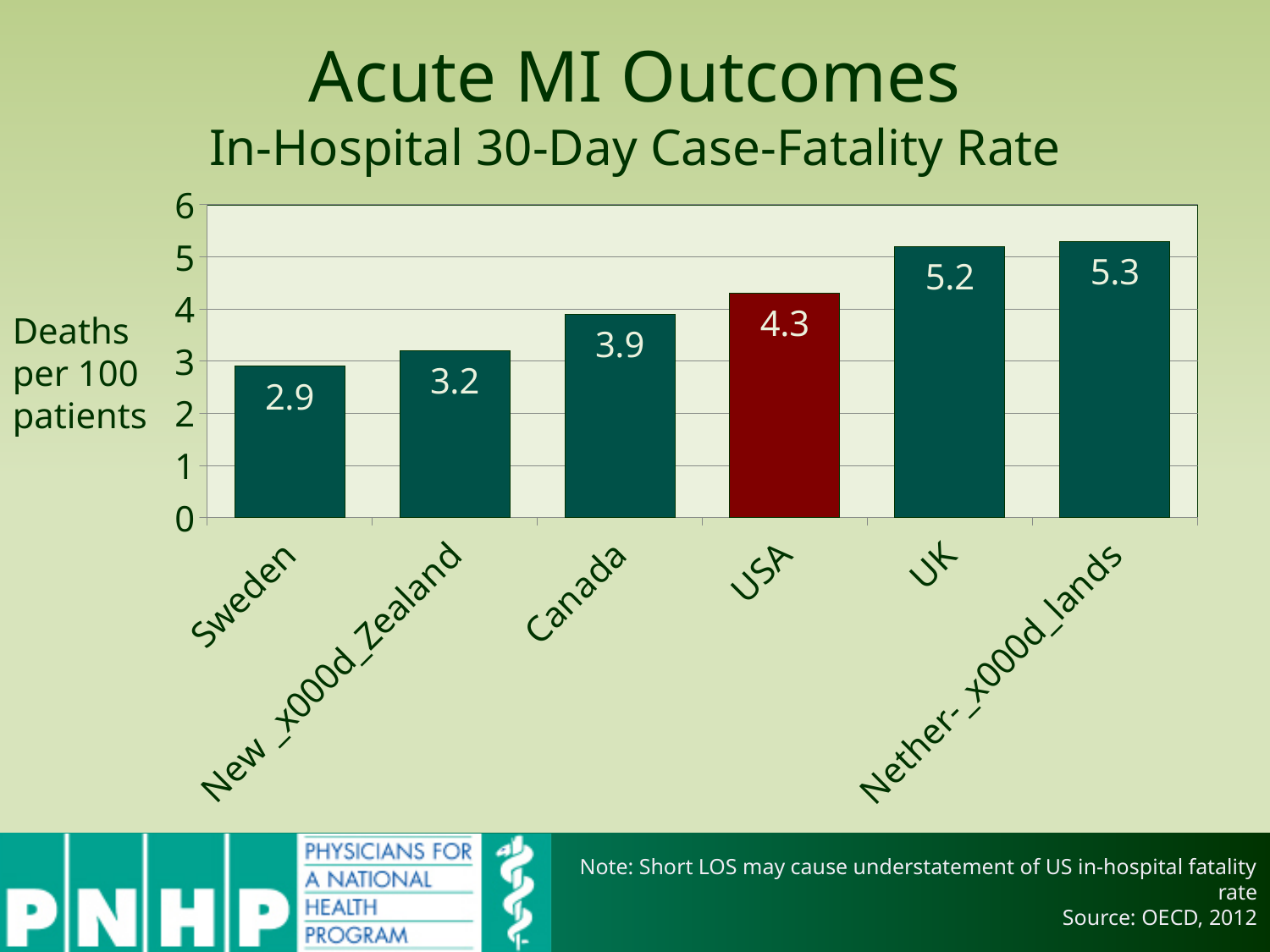
Which has a higher value, New Zealand or Canada? Canada How many countries are shown on the chart? 6 Which country has the lowest case-fatality rate on the chart? Sweden What type of chart is shown on the slide? Bar chart Which bar is coloured differently (red) from the others? USA What is the in-hospital 30-day case-fatality rate for the USA? 4.3 Which country has the highest case-fatality rate on the chart? Netherlands What is the value shown for Sweden? 2.9 What is the difference between the values for the UK and the USA? 0.9 What is the difference between the values for Canada and Sweden? 1.0 What is the value shown for the UK? 5.2 What is the value shown for Canada? 3.9